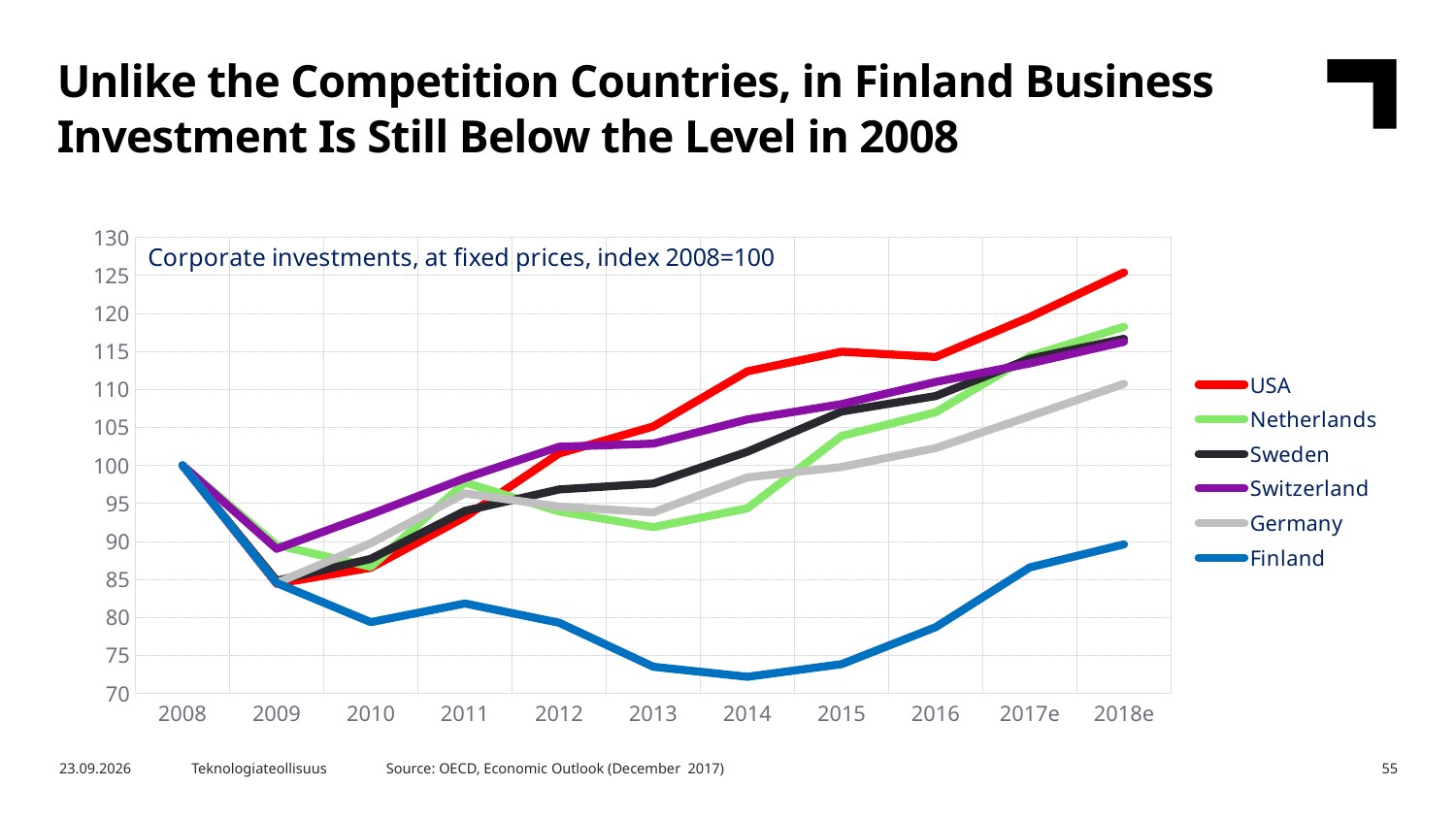
What is the title shown inside the chart area? Corporate investments, at fixed prices, index 2008=100 Is the value for Finland in 2014 greater or less than 75? less Does the value for Finland rise or fall from 2011 to 2014? fall What is the index value for Finland in 2008? 100 Which country has the lowest value in 2018e? Finland In 2016, which is larger, the value for USA or the value for Germany? USA How many years are shown along the x axis? 11 What kind of chart is shown on the slide? line chart How many series does the legend list? 6 Which country has the highest value in 2018e? USA Which country has the lowest value in 2010? Finland Is the value for USA in 2018e greater or less than 120? greater